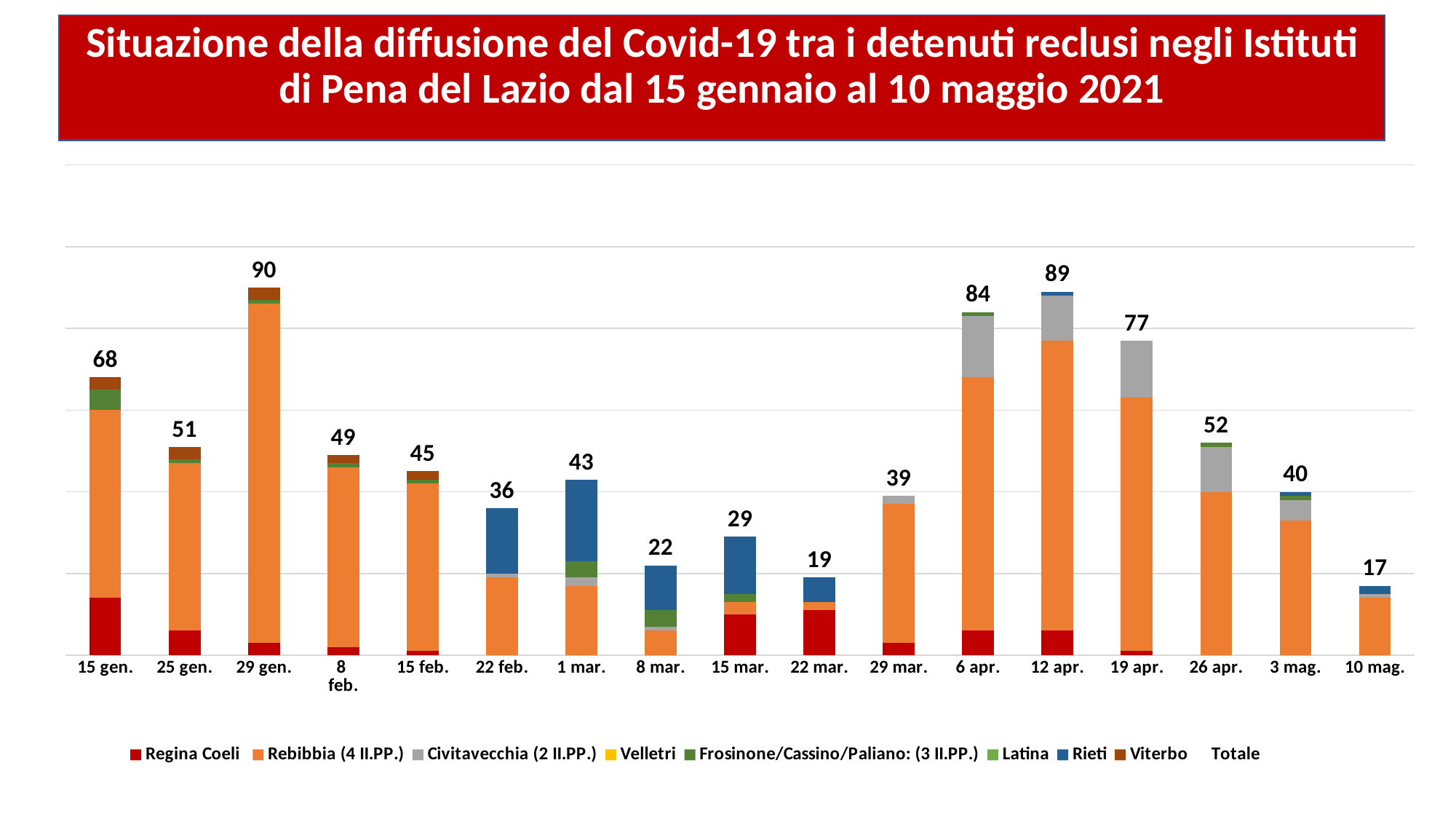
Which colour represents Rieti in the legend? Blue What is the total value shown above the bar for 29 gen.? 90 Which date has the highest total? 29 gen. What kind of chart is shown on the slide? Stacked bar chart What is the difference between the totals for 12 apr. and 6 apr.? 5 Which has the larger total, 15 gen. or 19 apr.? 19 apr. How many dates are shown on the x axis? 17 Do the totals rise or fall from 6 apr. to 10 mag.? Fall What is the difference between the totals for 29 gen. and 10 mag.? 73 What is the total value shown for 22 mar.? 19 How many entries does the legend list? 9 Which date has the lowest total? 10 mag.